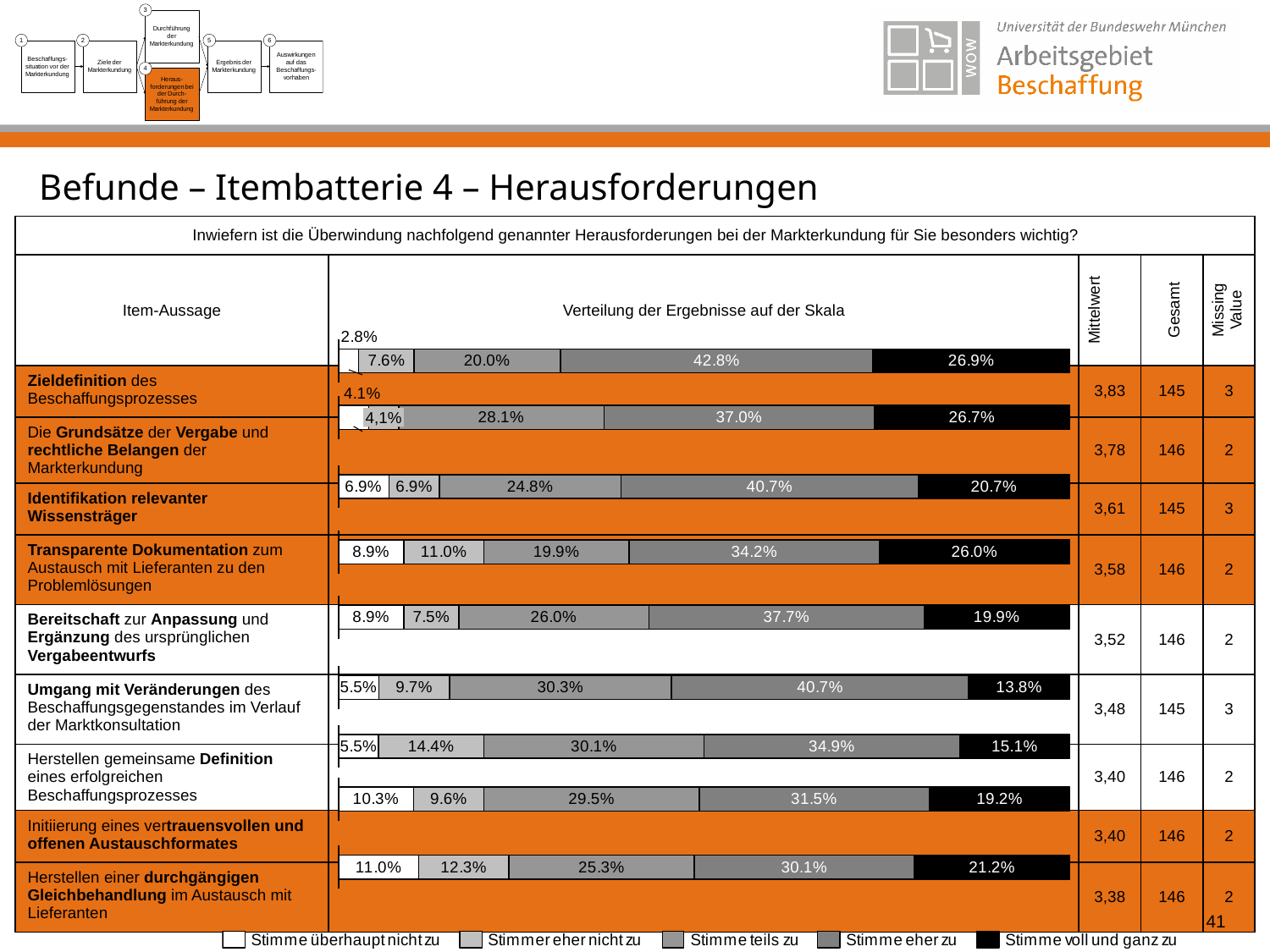
What is the Mittelwert for 'Identifikation relevanter Wissensträger'? 3,61 What is the difference between the 'Stimme eher zu' share (40.7%) and the 'Stimme voll und ganz zu' share (13.8%) for 'Umgang mit Veränderungen des Beschaffungsgegenstandes'? 26.9% How many item statements (bars) are shown in the chart? 9 In the bar for 'Transparente Dokumentation zum Austausch mit Lieferanten zu den Problemlösungen', which is larger: the 'Stimme eher zu' share or the 'Stimme voll und ganz zu' share? Stimme eher zu What is the 'Stimme teils zu' share for the item 'Umgang mit Veränderungen des Beschaffungsgegenstandes im Verlauf der Marktkonsultation'? 30.3% Which legend entry is represented by the black segments in the bars? Stimme voll und ganz zu What kind of chart is used to show the distribution of results on the scale? Stacked bar chart Which item has the highest Mittelwert? Zieldefinition des Beschaffungsprozesses Which item has the lowest Mittelwert? Herstellen einer durchgängigen Gleichbehandlung im Austausch mit Lieferanten What is the 'Stimme eher zu' share for the item 'Zieldefinition des Beschaffungsprozesses'? 42.8% How many response categories does the legend at the bottom of the chart list? 5 What is the 'Stimme voll und ganz zu' share for the item 'Zieldefinition des Beschaffungsprozesses'? 26.9%